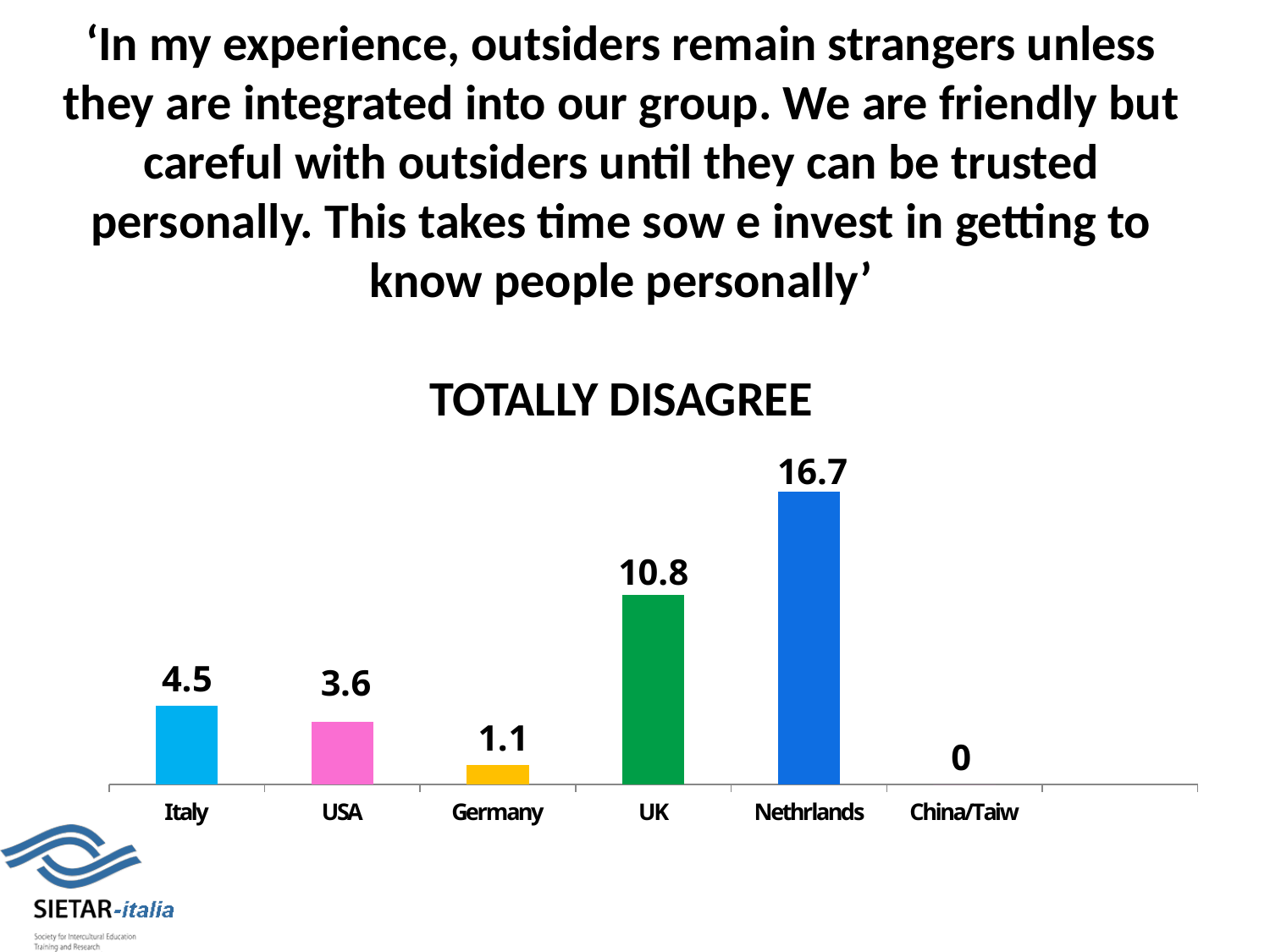
What is the value for Italy? 4.5 What kind of chart is shown on the slide? Bar chart Which category has the highest value? Nethrlands What is the difference between the values for Nethrlands and UK? 5.9 What is the difference between the values for Italy and USA? 0.9 What is the value for Germany? 1.1 How many categories are shown on the x axis? 6 What is the title of the chart? TOTALLY DISAGREE What is the value for China/Taiw? 0 What is the value for the UK? 10.8 Which is larger, the value for USA or the value for Germany? USA Which category has the lowest value? China/Taiw